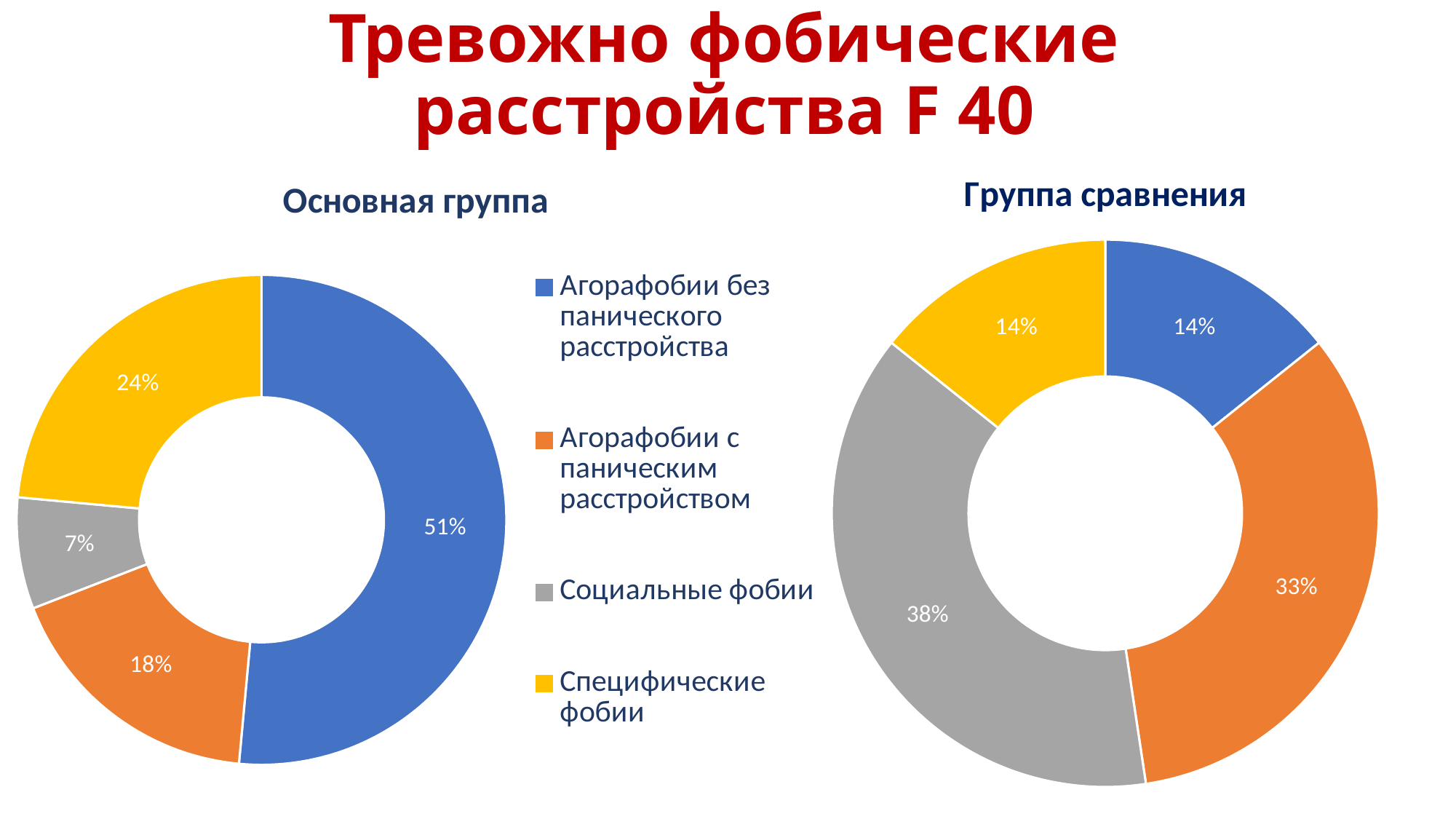
In the "Основная группа" chart, which category has the largest share? Агорафобии без панического расстройства Which chart shows a larger share for Агорафобии с паническим расстройством, "Основная группа" or "Группа сравнения"? Группа сравнения In the "Основная группа" chart, what share is shown for Агорафобии без панического расстройства? 51% What kind of chart is used for "Основная группа"? Doughnut (pie) chart How many categories does the legend list? 4 In the "Основная группа" chart, what is the difference between the shares of Специфические фобии and Агорафобии с паническим расстройством? 6% In the "Группа сравнения" chart, what is the difference between the shares of Социальные фобии and Агорафобии без панического расстройства? 24% In the "Группа сравнения" chart, which category has the largest share? Социальные фобии In the "Основная группа" chart, what share is shown for Социальные фобии? 7% In the "Группа сравнения" chart, what share is shown for Социальные фобии? 38% In the "Основная группа" chart, which category has the smallest share? Социальные фобии In the "Группа сравнения" chart, what share is shown for Агорафобии с паническим расстройством? 33%